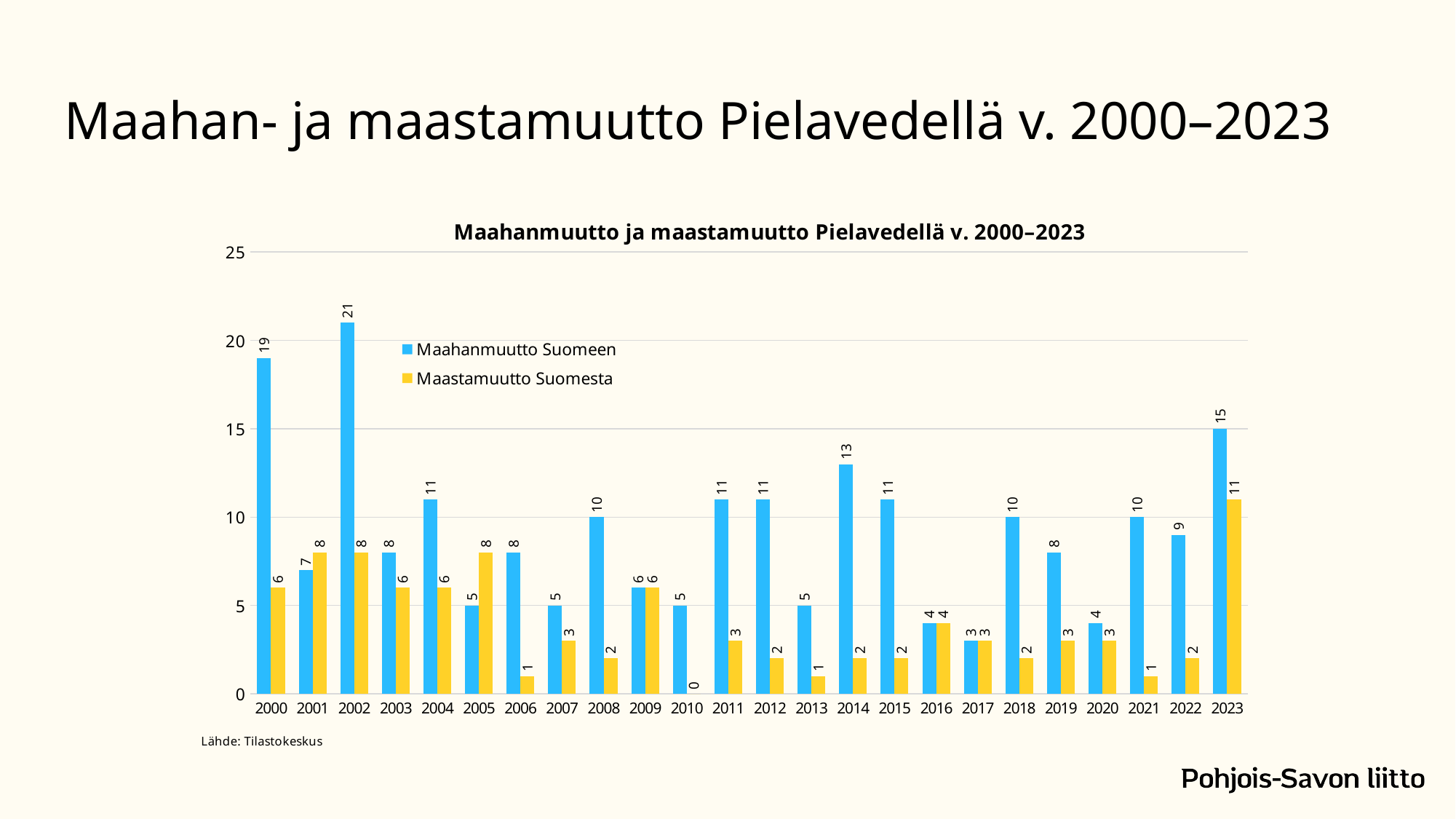
How many years are shown on the x axis? 24 What is the value of Maahanmuutto Suomeen for 2002? 21 Which is larger in 2005, Maahanmuutto Suomeen or Maastamuutto Suomesta? Maastamuutto Suomesta How many series does the legend list? 2 What is the difference between Maahanmuutto Suomeen and Maastamuutto Suomesta in 2000? 13 Which year has the highest value for Maastamuutto Suomesta? 2023 What is the value of Maastamuutto Suomesta for 2023? 11 What kind of chart is shown on the slide? Bar chart What is the value of Maahanmuutto Suomeen for 2014? 13 Which year has the lowest value for Maastamuutto Suomesta? 2010 What is the source given below the chart? Tilastokeskus Which year has the highest value for Maahanmuutto Suomeen? 2002